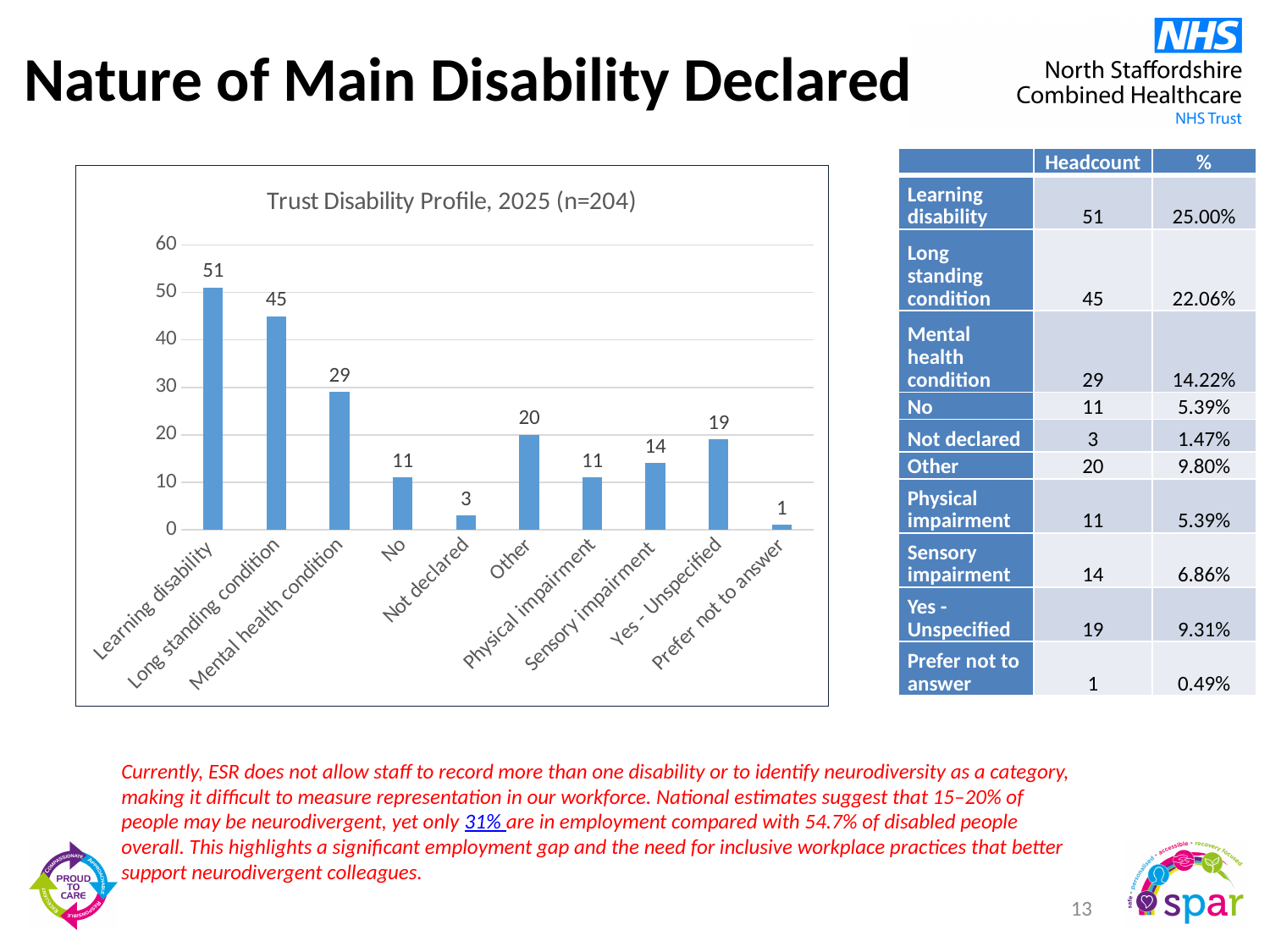
What is the difference between the values for Mental health condition and Other? 9 Which is larger, the value for Other or the value for Sensory impairment? Other Is the value for Mental health condition greater or less than 20? greater What is the value for Yes - Unspecified in the chart? 19 What is the value for Learning disability in the Trust Disability Profile chart? 51 How many categories are shown on the x axis of the chart? 10 What is the difference between the values for Learning disability and Long standing condition? 6 What kind of chart is shown on the slide? bar chart What is the title of the chart? Trust Disability Profile, 2025 (n=204) What is the value for Sensory impairment in the chart? 14 Which category has the highest value in the chart? Learning disability Which category has the lowest value in the chart? Prefer not to answer